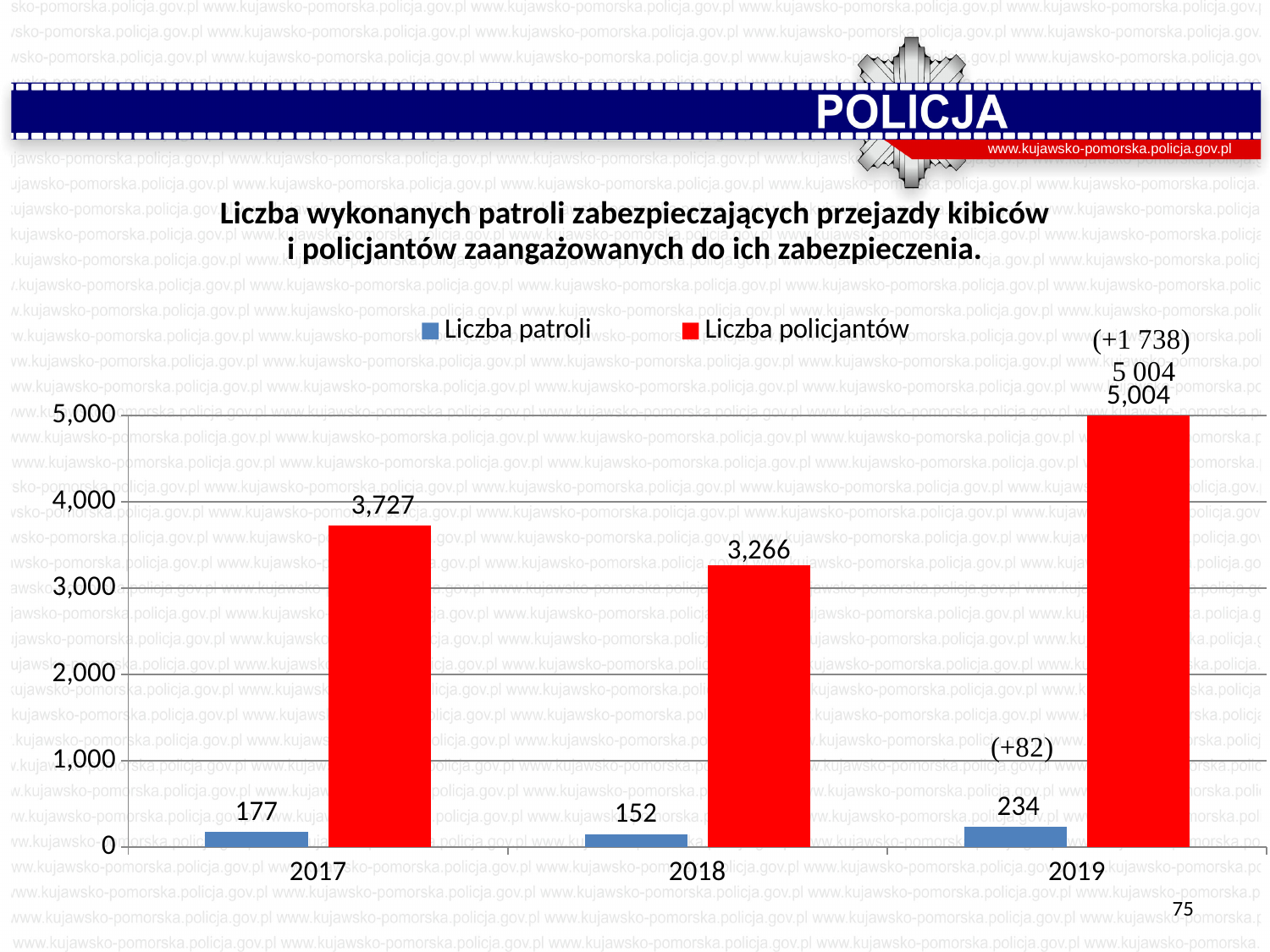
What is the difference between Liczba patroli in 2019 and in 2018? 82 How many years are shown on the x axis? 3 What is the difference between Liczba policjantów in 2019 and in 2018? 1,738 Which colour represents Liczba policjantów in the chart? red How many series does the legend list? 2 What is the value of Liczba policjantów for 2018? 3,266 Which is larger, Liczba policjantów in 2017 or in 2018? 2017 What is the value of Liczba patroli for 2017? 177 What type of chart is shown on the slide? bar chart In which year is Liczba patroli lowest? 2018 What is the value of Liczba policjantów for 2019? 5,004 In which year is Liczba policjantów highest? 2019